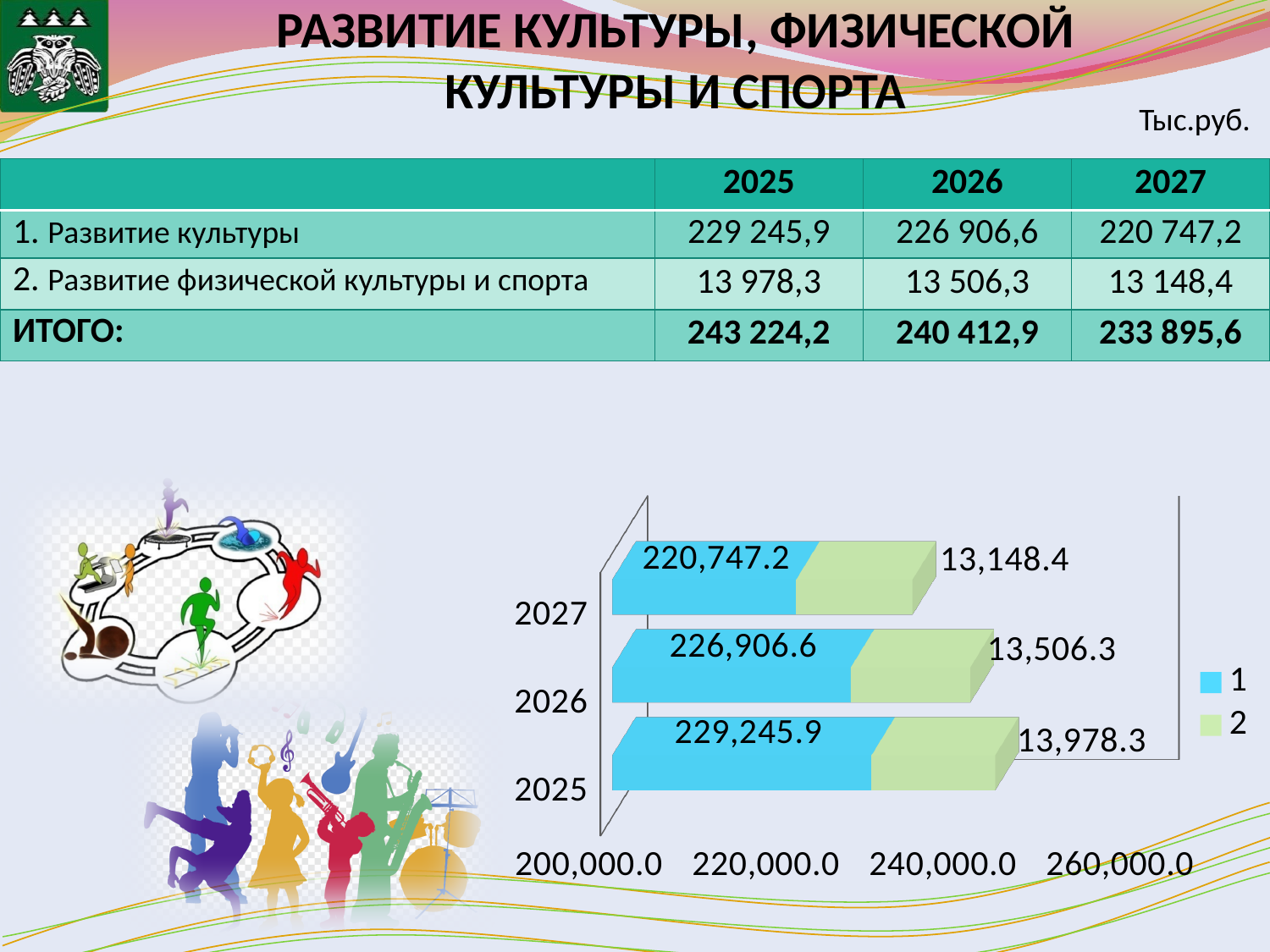
In the chart, what is the value of series 2 for 2026? 13,506.3 How many years are shown on the chart's vertical axis? 3 In the chart, what is the value of series 1 for 2025? 229,245.9 In the chart, is the series 2 value for 2026 larger or smaller than the series 2 value for 2027? Larger In the chart, what is the total of the stacked bar for 2026? 240,412.9 In the chart, what is the value of series 2 for 2025? 13,978.3 How many series does the chart's legend list? 2 In the chart, what is the difference between the series 1 values for 2025 and 2027? 8,498.7 What type of chart is shown on the slide? Stacked bar chart In the chart, which year has the highest value for series 1? 2025 In the chart, which year has the lowest value for series 2? 2027 In the chart, what is the value of series 1 for 2027? 220,747.2